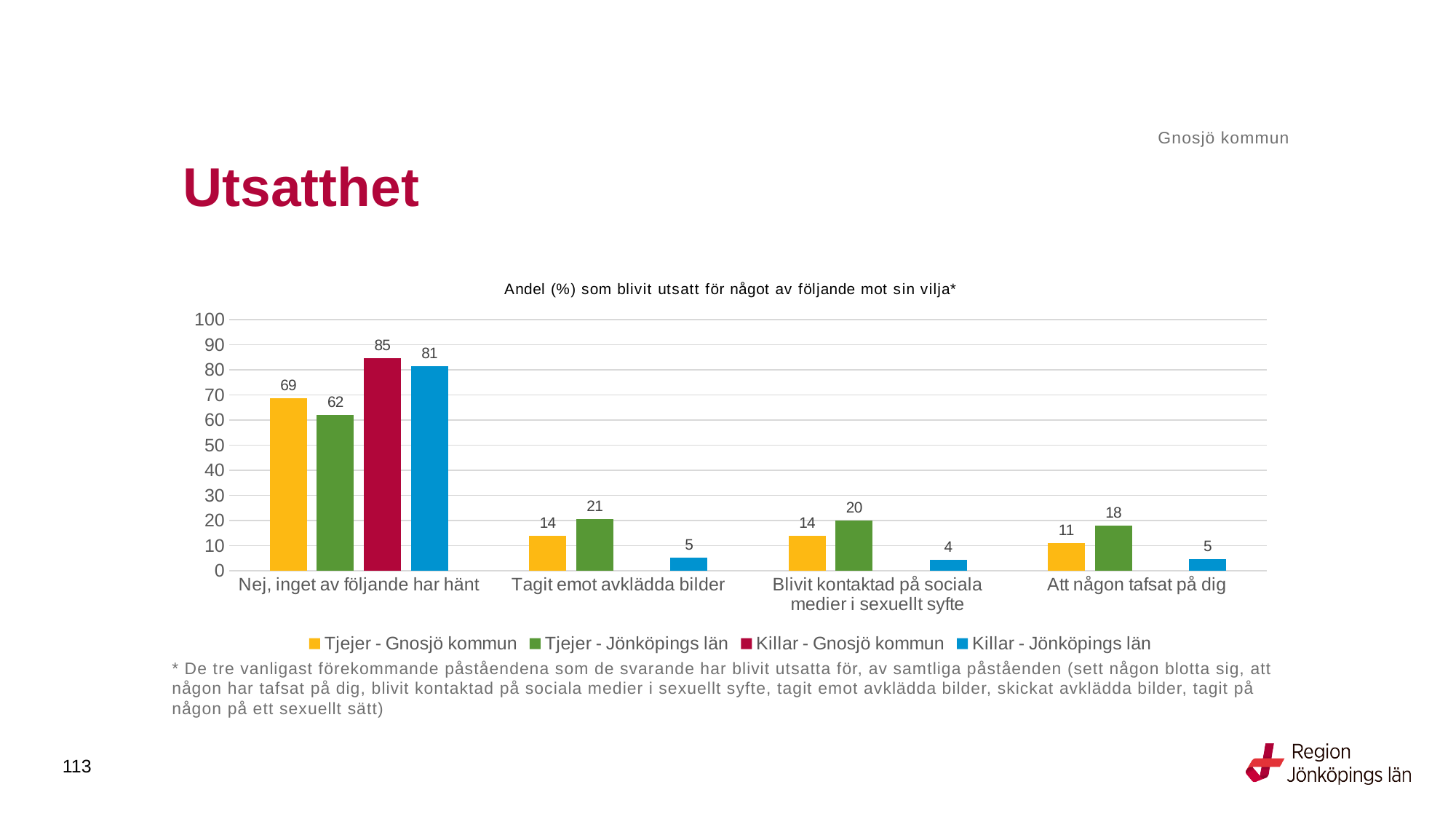
What kind of chart is shown on the slide? bar chart What is the value for Tjejer - Jönköpings län in the category "Tagit emot avklädda bilder"? 21 Which series has the lowest value in the category "Tagit emot avklädda bilder"? Killar - Jönköpings län What is the value for Killar - Jönköpings län in the category "Blivit kontaktad på sociala medier i sexuellt syfte"? 4 Is the value for Killar - Jönköpings län in "Nej, inget av följande har hänt" greater or less than 70? greater What is the difference between Tjejer - Gnosjö kommun and Tjejer - Jönköpings län in the category "Nej, inget av följande har hänt"? 7 Which series has the highest value in the category "Nej, inget av följande har hänt"? Killar - Gnosjö kommun What is the value for Killar - Gnosjö kommun in the category "Nej, inget av följande har hänt"? 85 How many series does the legend list? 4 Which is larger in the category "Att någon tafsat på dig": Tjejer - Gnosjö kommun or Tjejer - Jönköpings län? Tjejer - Jönköpings län What is the value for Tjejer - Gnosjö kommun in the category "Att någon tafsat på dig"? 11 How many categories are shown on the x axis? 4